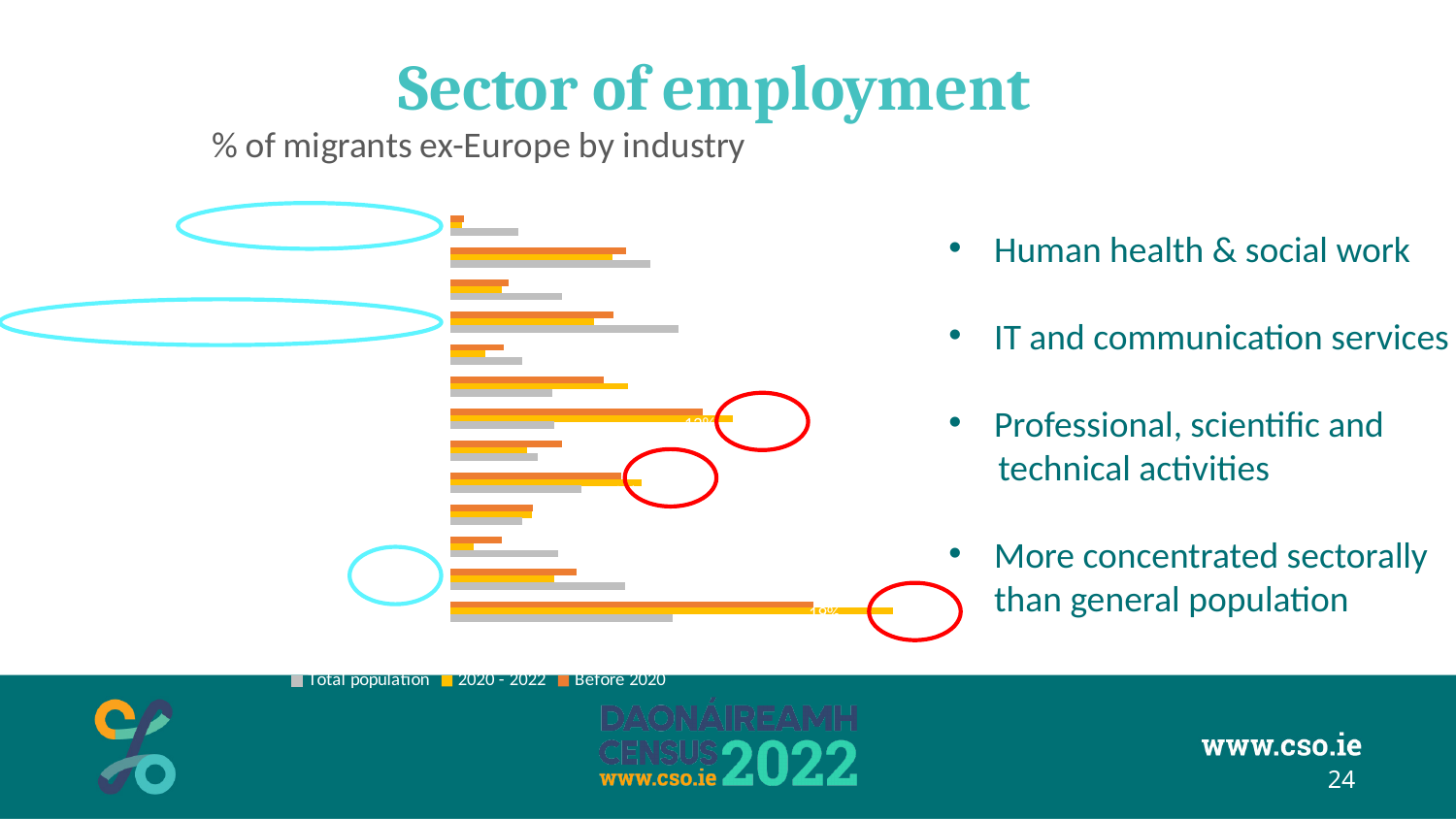
How many category groups of bars are plotted in the chart? 13 In the top category group, which bar is longer: Total population or Before 2020? Total population Which two percentage values are printed as data labels on the chart? 13% and 19% How many series does the chart's legend list? 3 In the bottom category group, which series has the shortest bar? Total population What kind of chart is shown on the slide? bar chart In the bottom category group, which bar is longer: Total population or 2020 - 2022? 2020 - 2022 What are the three series named in the chart's legend? Total population, 2020 - 2022, Before 2020 What is the largest value printed as a data label on the chart? 19% Which series has the longest bar anywhere on the chart? 2020 - 2022 What subtitle describes what the chart measures? % of migrants ex-Europe by industry